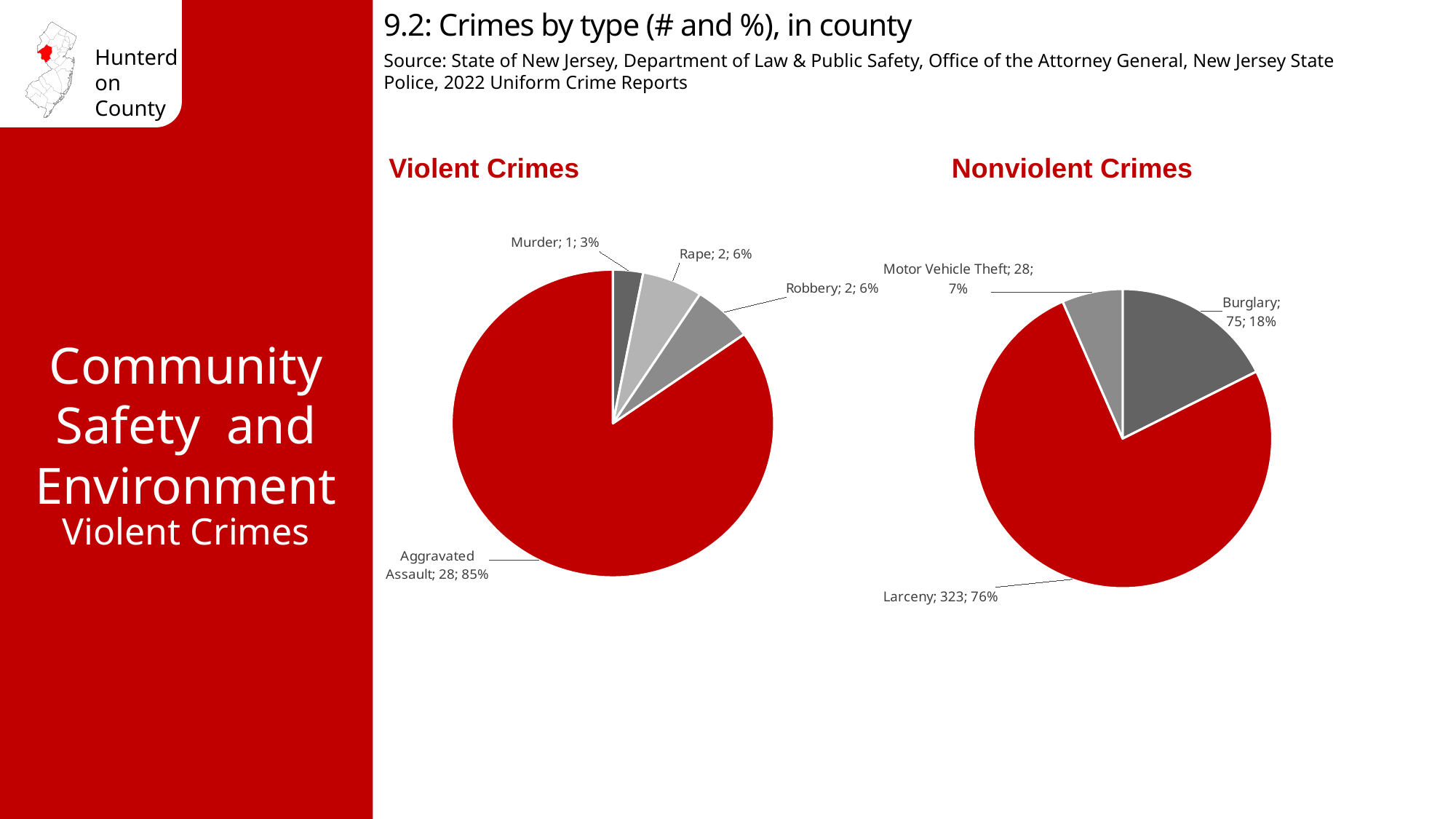
In the Violent Crimes chart, what percentage share does Murder have? 3% What type of chart is used for the Violent Crimes data? Pie chart In the Nonviolent Crimes chart, how many larcenies are shown? 323 In the Violent Crimes chart, which category has the smallest slice? Murder In the Violent Crimes chart, how many aggravated assaults are shown? 28 In the Nonviolent Crimes chart, what is the difference between the number of larcenies and the number of burglaries? 248 In the Nonviolent Crimes chart, what percentage share does Burglary have? 18% In the Nonviolent Crimes chart, which is larger, Burglary or Motor Vehicle Theft? Burglary What is the title of the slide? 9.2: Crimes by type (# and %), in county In the Violent Crimes chart, which category has the largest slice? Aggravated Assault In the Nonviolent Crimes chart, which category has the smallest slice? Motor Vehicle Theft In the Violent Crimes chart, how many categories are shown? 4